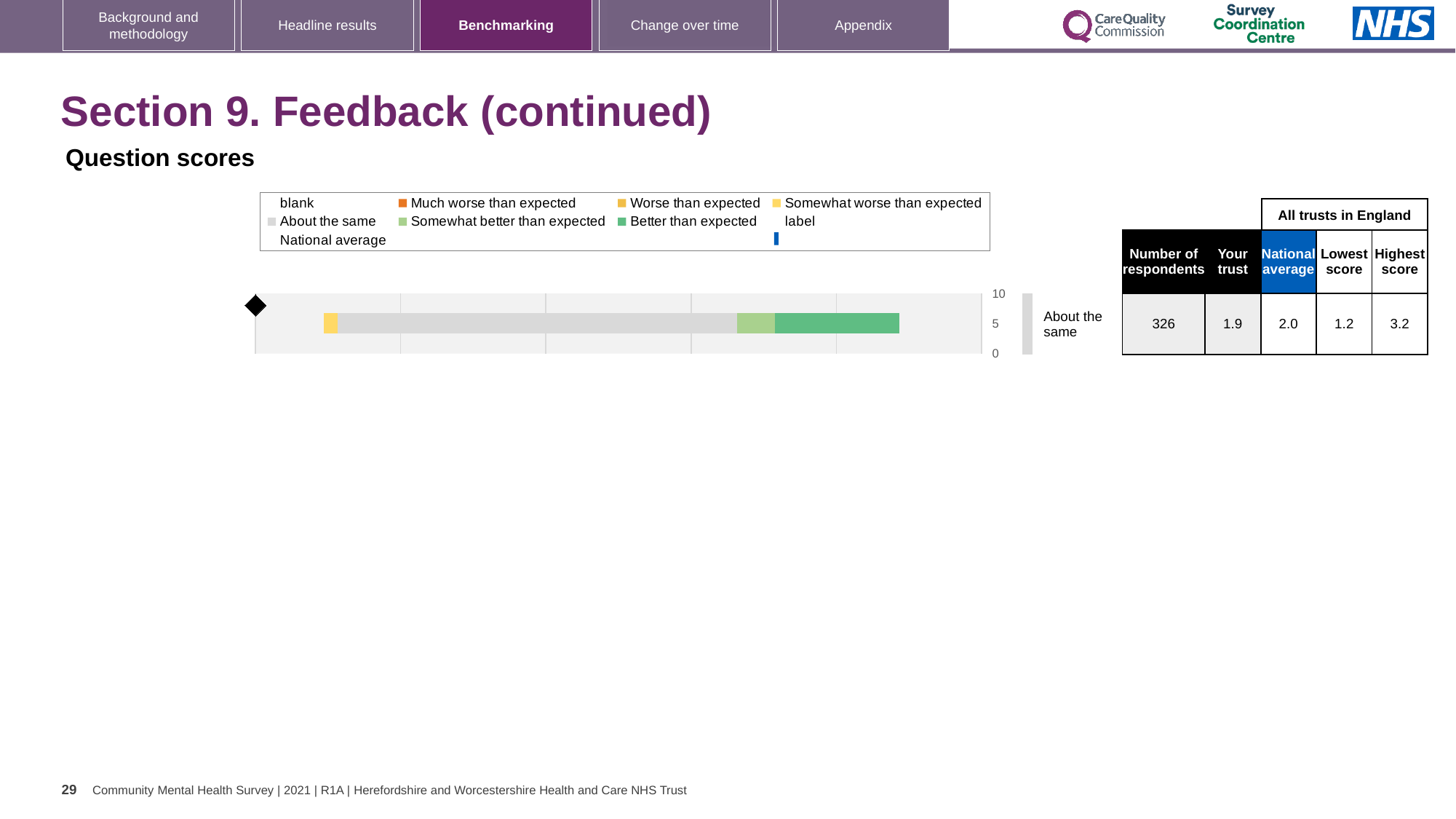
Which visible segment of the bar is the narrowest? Somewhat worse than expected Which segment of the bar is the widest? About the same How many bars does the chart contain? 1 According to the table beside the chart, what is the score for 'Your trust'? 1.9 Which is larger in the table: the 'Your trust' score or the National average? National average According to the table beside the chart, what is the National average score? 2.0 According to the table beside the chart, what is the Highest score among all trusts in England? 3.2 Which colour does the legend use for 'Better than expected'? green What is the difference between the Highest score and the Lowest score in the table? 2.0 What is the category label shown next to the bar in the chart? About the same According to the table beside the chart, how many respondents were there? 326 What kind of chart is shown on the slide? bar chart